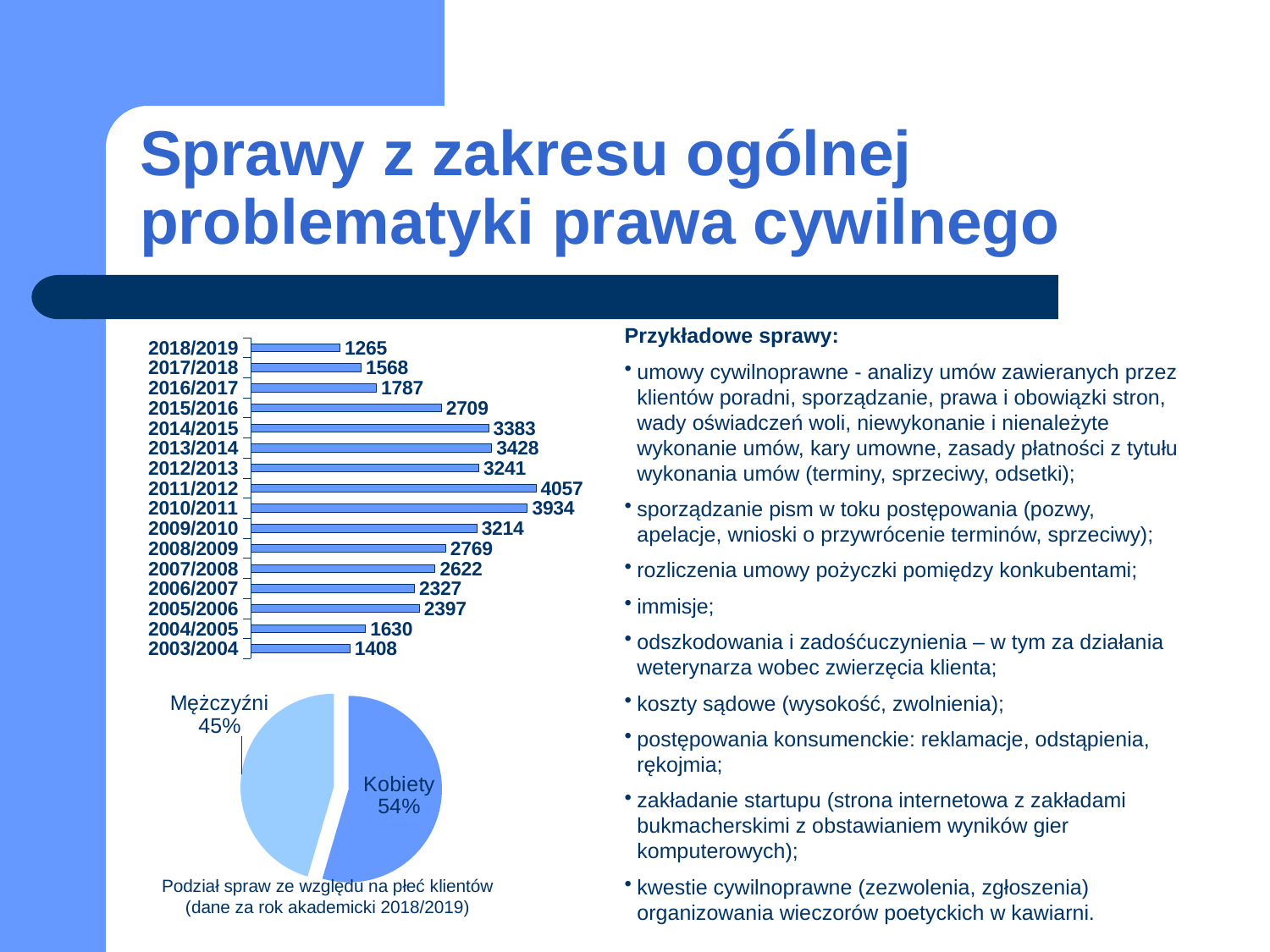
What kind of chart is the chart at the bottom left of the slide? pie chart In the bar chart at the top left of the slide, what is the difference between the values for 2011/2012 and 2018/2019? 2792 What kind of chart is the chart at the top left of the slide? bar chart In the bar chart at the top left of the slide, what is the value for 2011/2012? 4057 In the pie chart at the bottom left of the slide, what share is labelled for Mężczyźni? 45% In the pie chart at the bottom left of the slide, what share is labelled for Kobiety? 54% In the bar chart at the top left of the slide, what is the value for 2015/2016? 2709 In the bar chart at the top left of the slide, which academic year has the lowest value? 2018/2019 How many academic years are shown in the bar chart at the top left of the slide? 16 In the bar chart at the top left of the slide, which is larger, the value for 2013/2014 or the value for 2014/2015? 2013/2014 In the bar chart at the top left of the slide, which academic year has the highest value? 2011/2012 In the bar chart at the top left of the slide, what is the value for 2003/2004? 1408